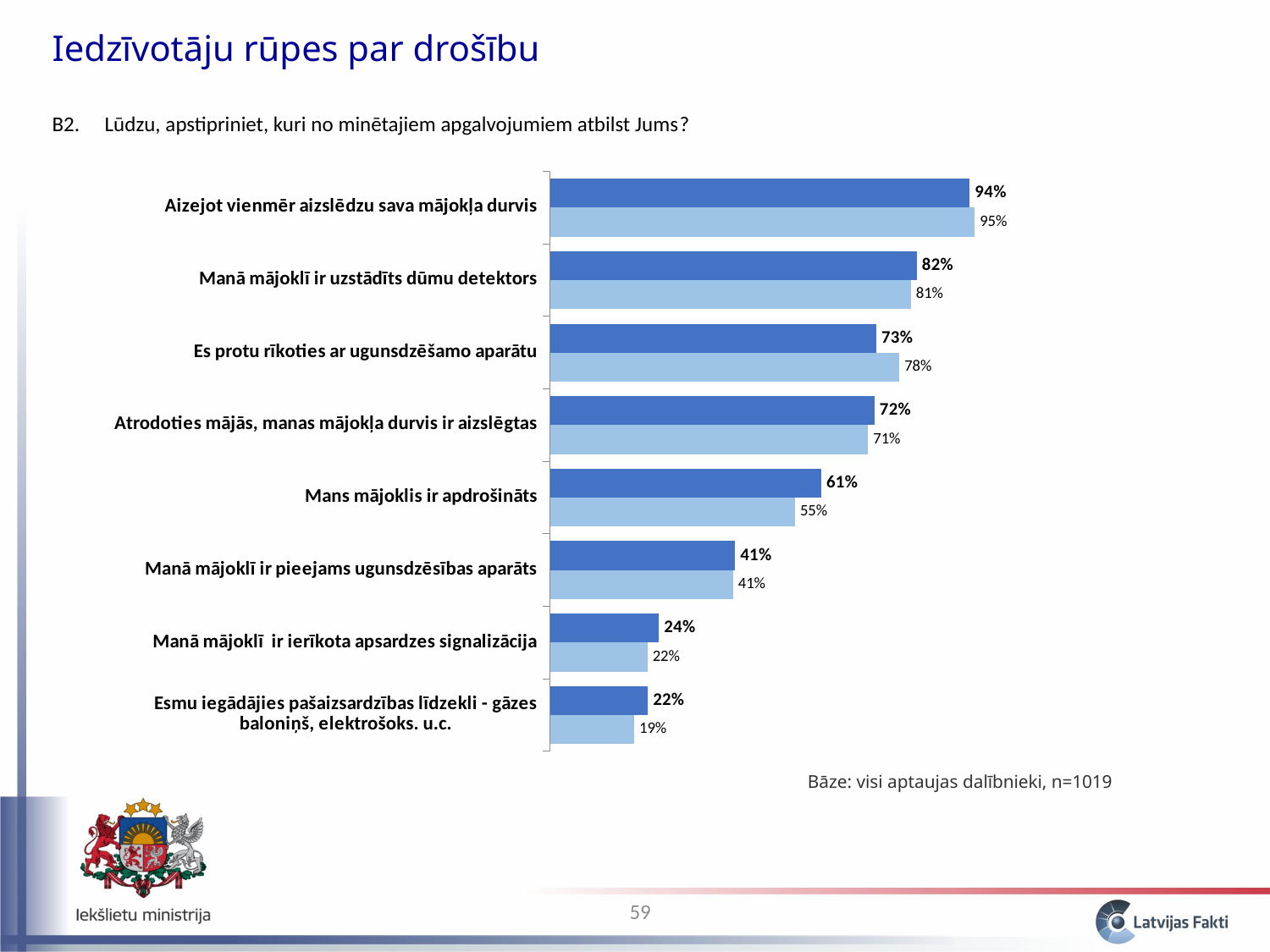
What type of chart is shown on the slide? bar chart What is the base (sample size) stated below the chart? n=1019 What is the value of the light blue bar for "Es protu rīkoties ar ugunsdzēšamo aparātu"? 78% What is the difference between the dark blue and light blue bar values for "Es protu rīkoties ar ugunsdzēšamo aparātu"? 5% What is the value of the light blue bar for "Aizejot vienmēr aizslēdzu sava mājokļa durvis"? 95% What is the difference between the dark blue and light blue bar values for "Mans mājoklis ir apdrošināts"? 6% Which category has the lowest dark blue bar value? Esmu iegādājies pašaizsardzības līdzekli - gāzes baloniņš, elektrošoks. u.c. How many categories are shown in the chart? 8 What is the value of the dark blue bar for "Mans mājoklis ir apdrošināts"? 61% For "Manā mājoklī ir ierīkota apsardzes signalizācija", which bar is larger, the dark blue or the light blue? dark blue What is the value of the dark blue bar for "Aizejot vienmēr aizslēdzu sava mājokļa durvis"? 94% Which category has the highest light blue bar value? Aizejot vienmēr aizslēdzu sava mājokļa durvis